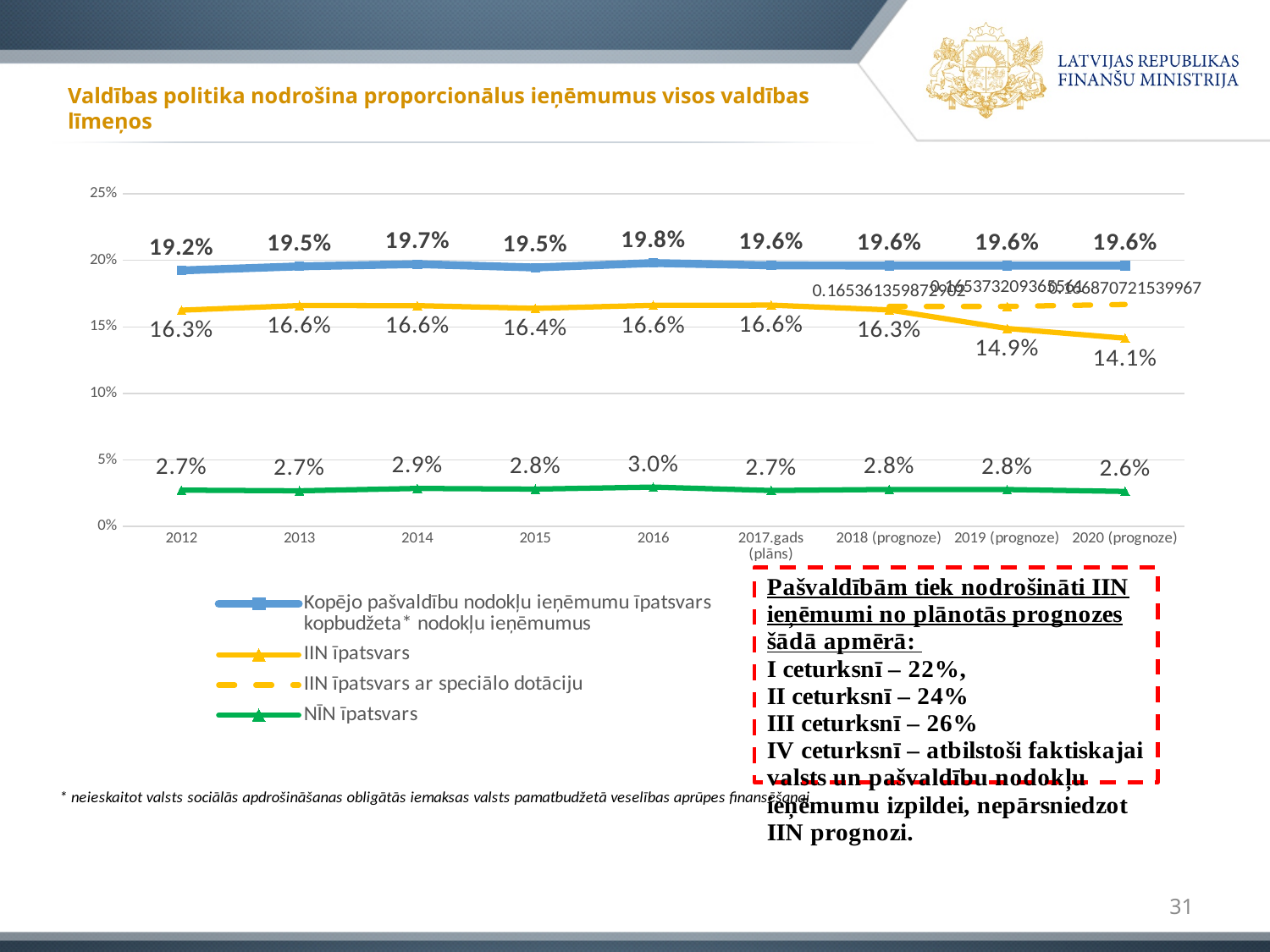
What is the value of NĪN īpatsvars for 2016? 3.0% What colour is the line for NĪN īpatsvars? green Which is larger: NĪN īpatsvars in 2016 or in 2020 (prognoze)? 2016 In which year does the Kopējo pašvaldību nodokļu ieņēmumu īpatsvars series reach its highest value? 2016 Does IIN īpatsvars rise or fall from 2017.gads (plāns) to 2020 (prognoze)? fall What type of chart is shown on the slide? line chart What is the difference between IIN īpatsvars in 2019 (prognoze) and 2020 (prognoze)? 0.8% In which category does IIN īpatsvars have its lowest value? 2020 (prognoze) What is the value of the Kopējo pašvaldību nodokļu ieņēmumu īpatsvars series for 2012? 19.2% How many categories are shown on the x axis of the chart? 9 How many series does the chart legend list? 4 What is the value of IIN īpatsvars for 2020 (prognoze)? 14.1%